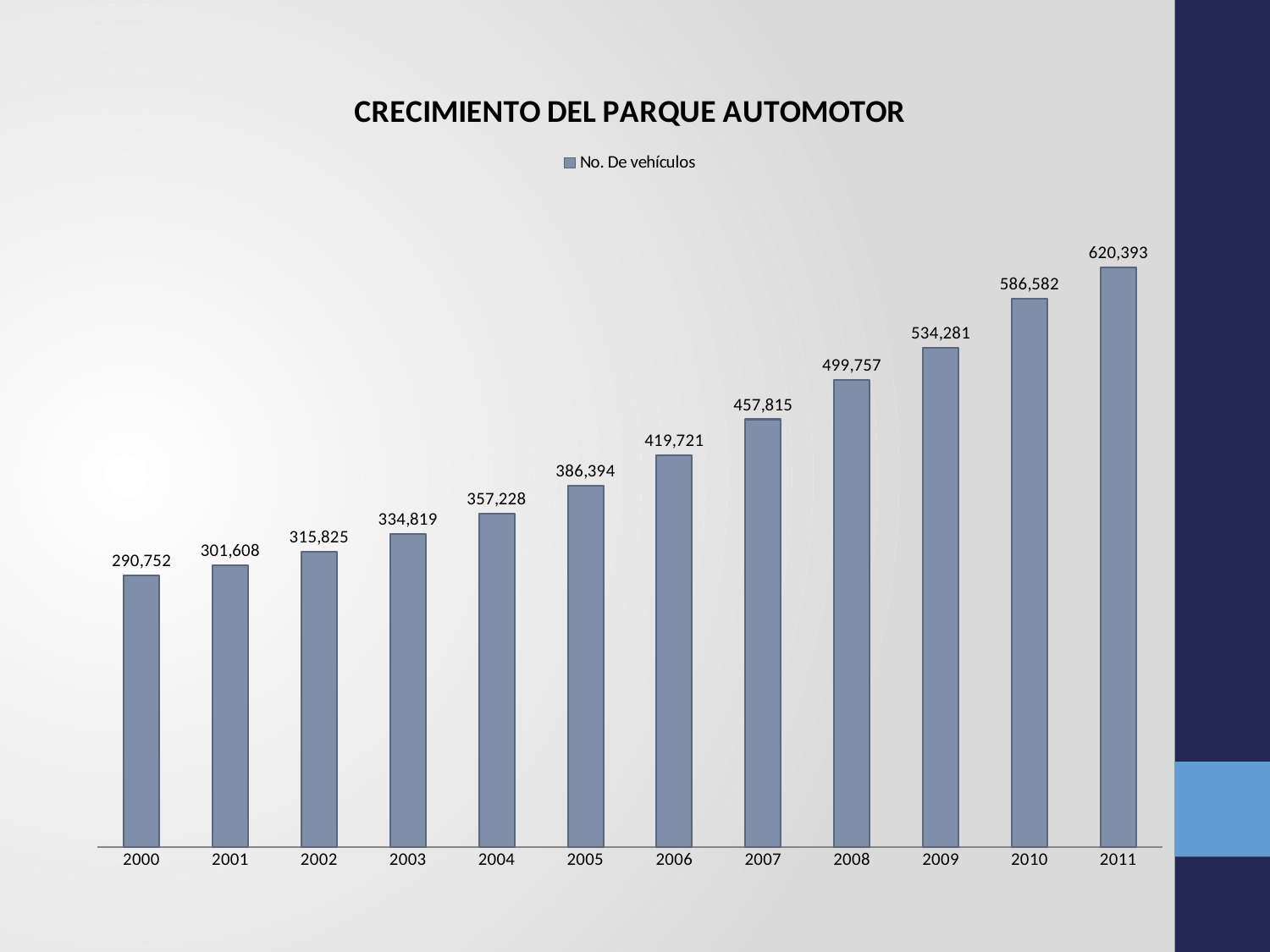
What is the value for 2000? 290,752 Which year has the lowest value? 2000 What is the title of the chart? CRECIMIENTO DEL PARQUE AUTOMOTOR Which year has the highest value? 2011 How many years are shown on the x axis? 12 What is the difference between the values for 2011 and 2000? 329,641 Which is larger, the value for 2003 or the value for 2007? 2007 What is the value for 2008? 499,757 What is the value for 2005? 386,394 What is the difference between the values for 2010 and 2009? 52,301 What type of chart is shown on the slide? Bar chart Do the values rise or fall from 2000 to 2011? Rise